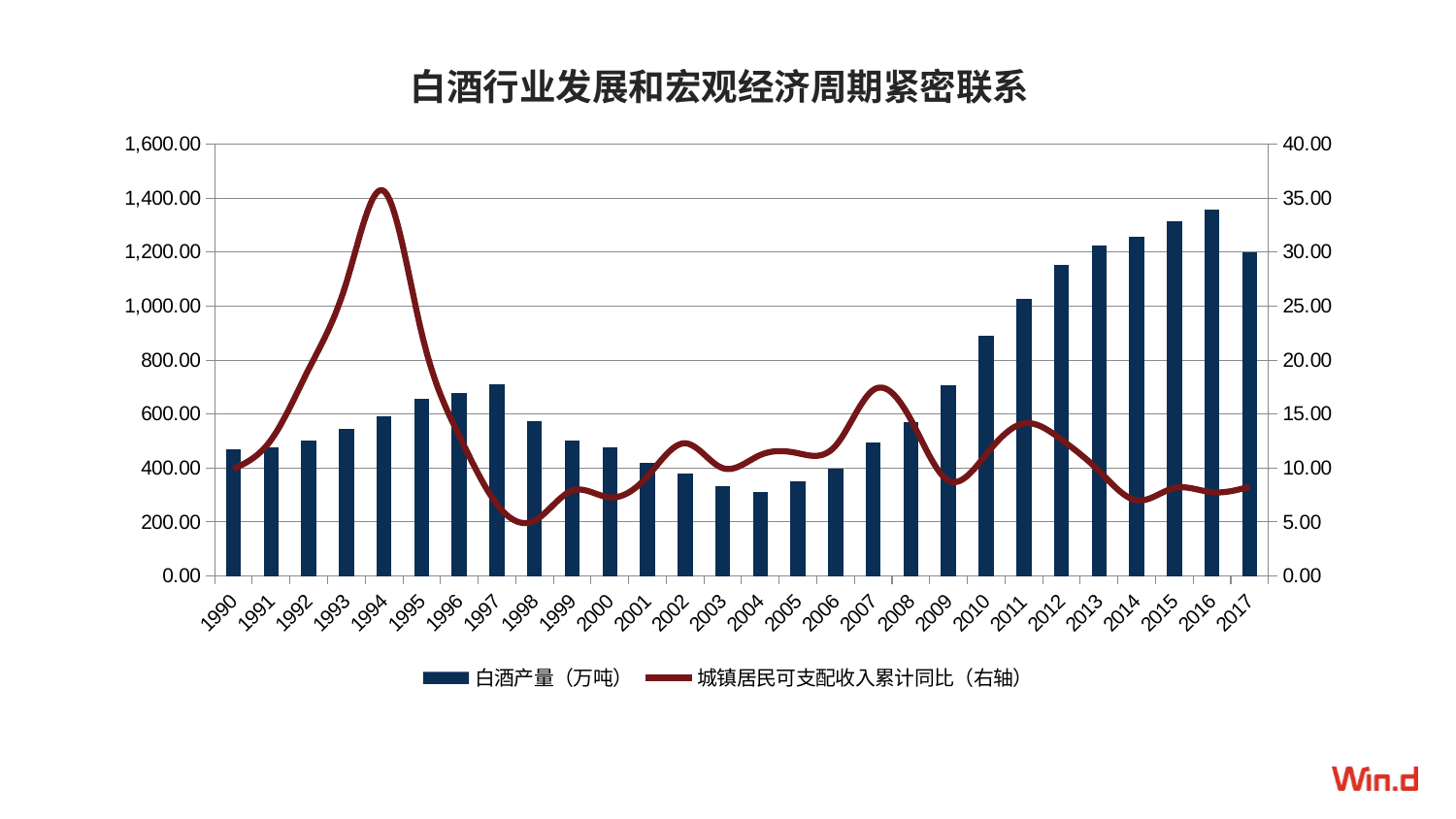
Is the 城镇居民可支配收入累计同比 value for 1994 greater or less than 30.00 on the right axis? greater Which year has the lowest bar for 白酒产量（万吨）? 2004 What is the title of the chart? 白酒行业发展和宏观经济周期紧密联系 How many series does the legend list? 2 How many years are shown on the x axis? 28 Which year has the larger 白酒产量 bar, 2016 or 2017? 2016 Is the 白酒产量 bar for 2016 greater or less than 1,200.00? greater In which year does the line 城镇居民可支配收入累计同比（右轴） reach its peak? 1994 What kind of chart is this? Bar chart combined with a line chart Do the 白酒产量 bars rise or fall from 2009 to 2016? rise Which year has the highest bar for 白酒产量（万吨）? 2016 Is the 白酒产量 bar for 2004 greater or less than 400.00? less